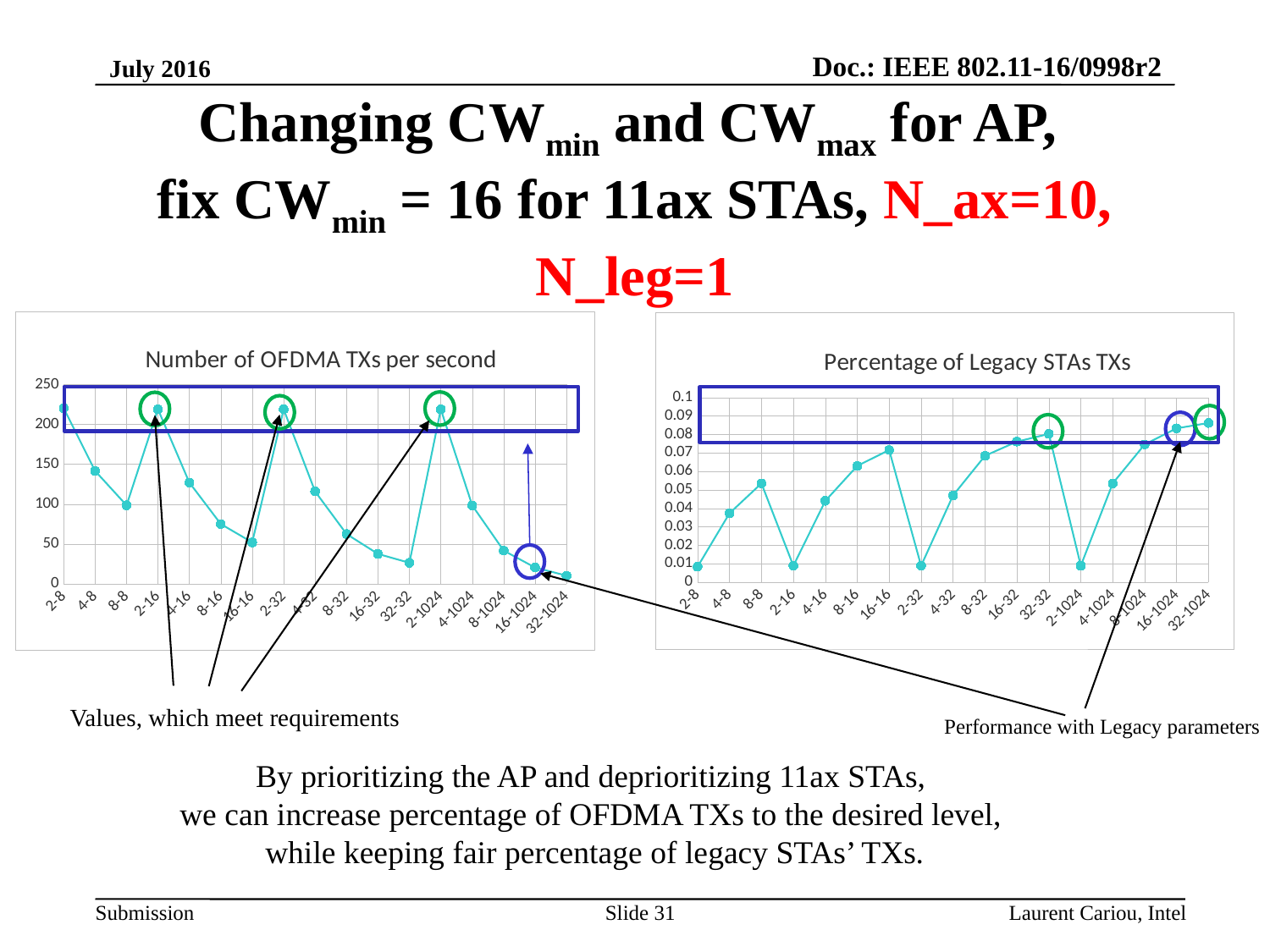
In the 'Percentage of Legacy STAs TXs' chart, is the value for 2-8 greater or less than 0.02? less In the 'Number of OFDMA TXs per second' chart, is the value for 16-16 greater or less than 100? less In the 'Number of OFDMA TXs per second' chart, is the value for 2-32 greater or less than 200? greater How many categories are shown on the x axis of the 'Percentage of Legacy STAs TXs' chart? 17 What type of chart is the 'Number of OFDMA TXs per second' chart? line chart What is the title of the chart on the right side of the slide? Percentage of Legacy STAs TXs In the 'Number of OFDMA TXs per second' chart, which is larger, the value for 4-8 or the value for 8-8? 4-8 In the 'Percentage of Legacy STAs TXs' chart, which is larger, the value for 8-8 or the value for 4-8? 8-8 In the 'Percentage of Legacy STAs TXs' chart, do the values rise or fall from 2-1024 to 32-1024? rise In the 'Number of OFDMA TXs per second' chart, which category has the lowest value? 32-1024